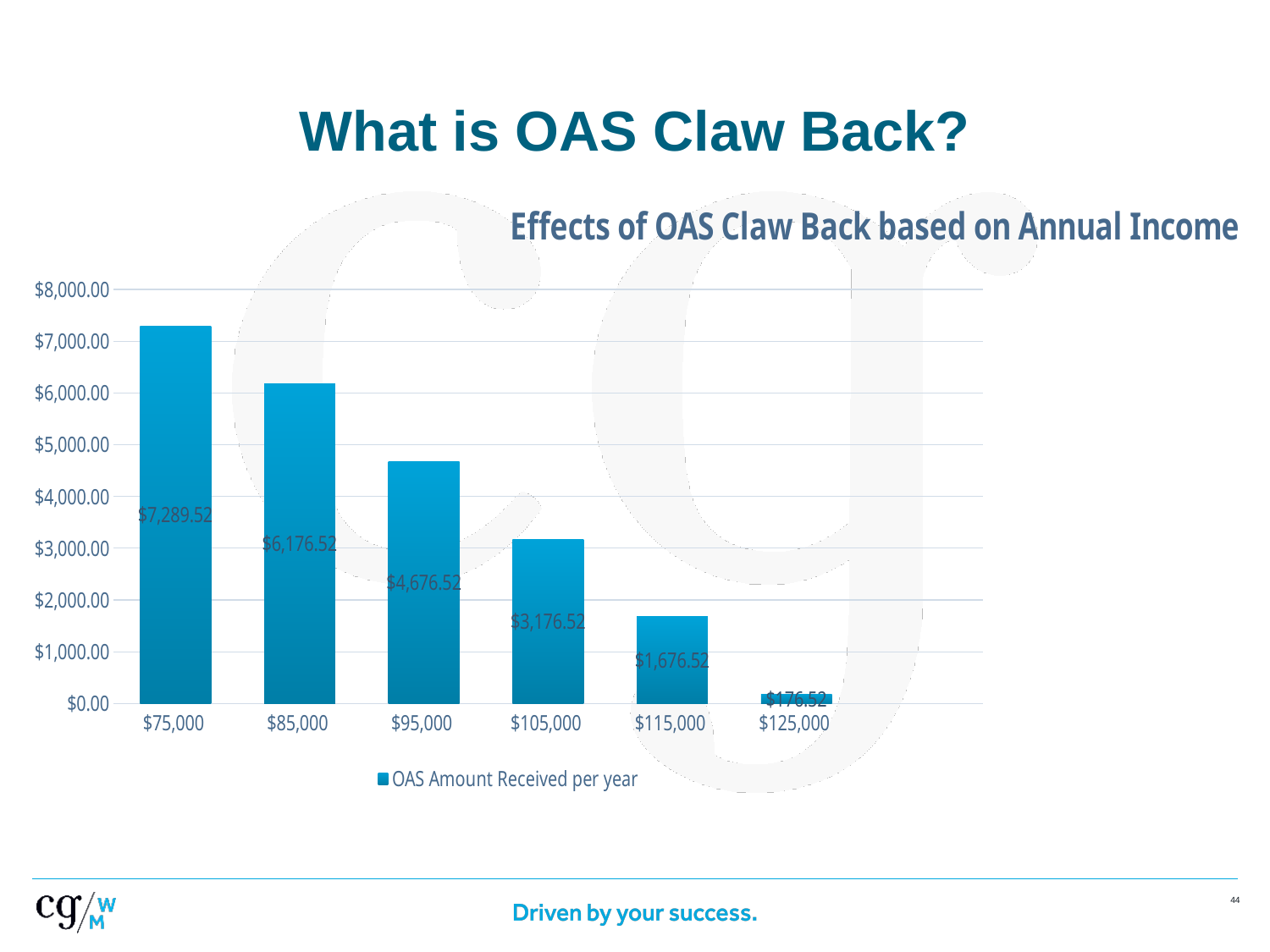
What is the OAS Amount Received per year at an annual income of $95,000? $4,676.52 Which income level receives a larger OAS amount per year, $105,000 or $115,000? $105,000 How many series does the legend list? 1 Which annual income level has the lowest OAS Amount Received per year? $125,000 What is the OAS Amount Received per year at an annual income of $75,000? $7,289.52 Which annual income level has the highest OAS Amount Received per year? $75,000 Is the OAS Amount Received per year at $85,000 greater or less than $6,000.00? greater How many annual income levels are shown on the x axis? 6 Do the OAS amounts rise or fall as annual income increases along the x axis? Fall What is the OAS Amount Received per year at an annual income of $125,000? $176.52 What is the difference in OAS Amount Received per year between the $85,000 and $105,000 income levels? $3,000.00 What kind of chart is shown on the slide? Bar chart